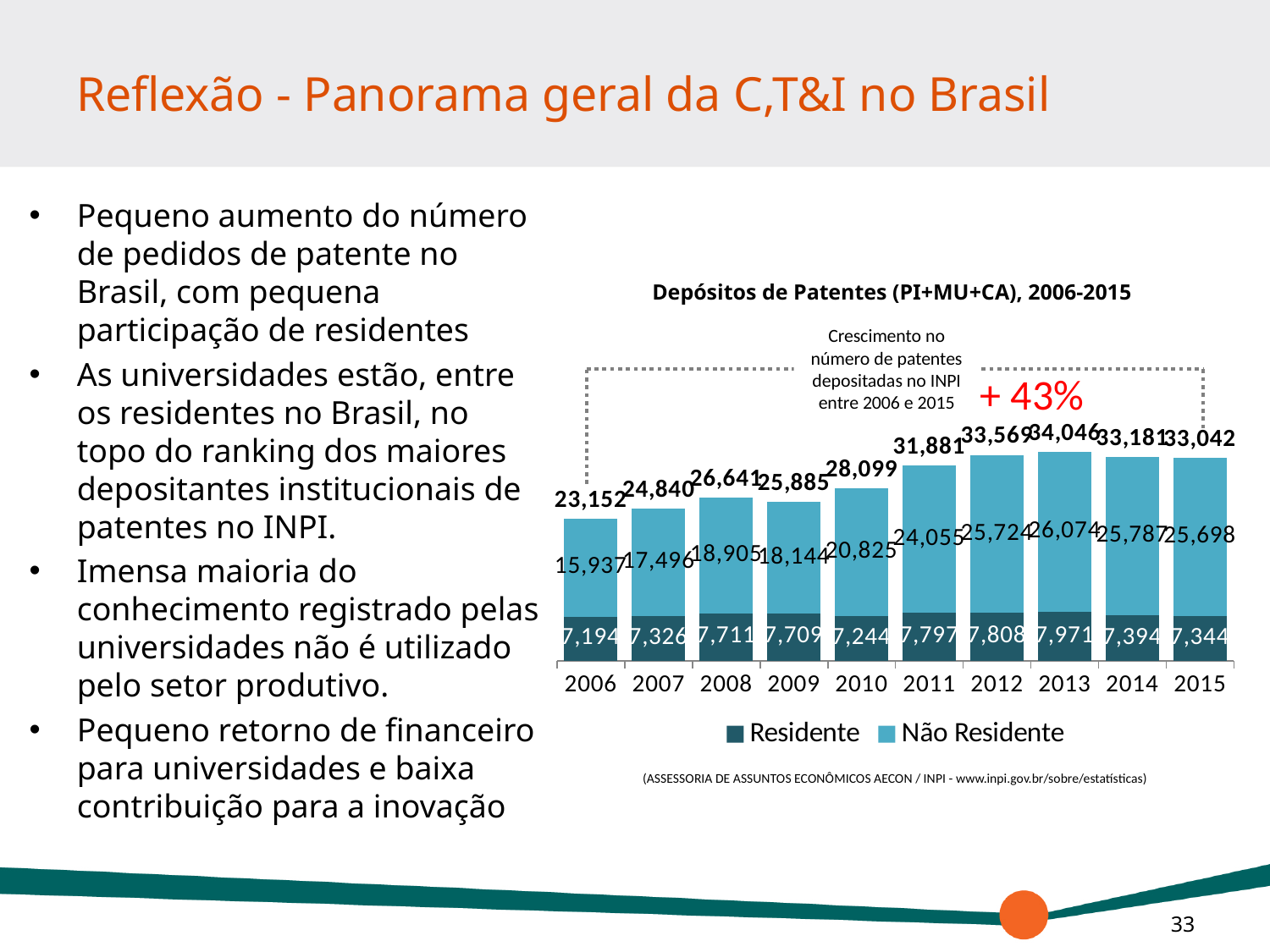
What growth percentage in patent deposits between 2006 and 2015 is annotated on the chart? + 43% What kind of chart is shown on the slide? bar chart Which year has the lowest total number of patent deposits? 2006 How many years are shown on the x axis of the chart? 10 Which year has the larger Residente value, 2010 or 2012? 2012 What is the Não Residente value for 2010? 20,825 Do the Não Residente values rise or fall from 2006 to 2013? rise What is the total number of patent deposits shown for 2011? 31,881 How many series does the legend of the chart list? 2 What is the Residente value for 2013? 7,971 What is the difference between the Não Residente values for 2011 and 2006? 8,118 Which year has the highest total number of patent deposits? 2013